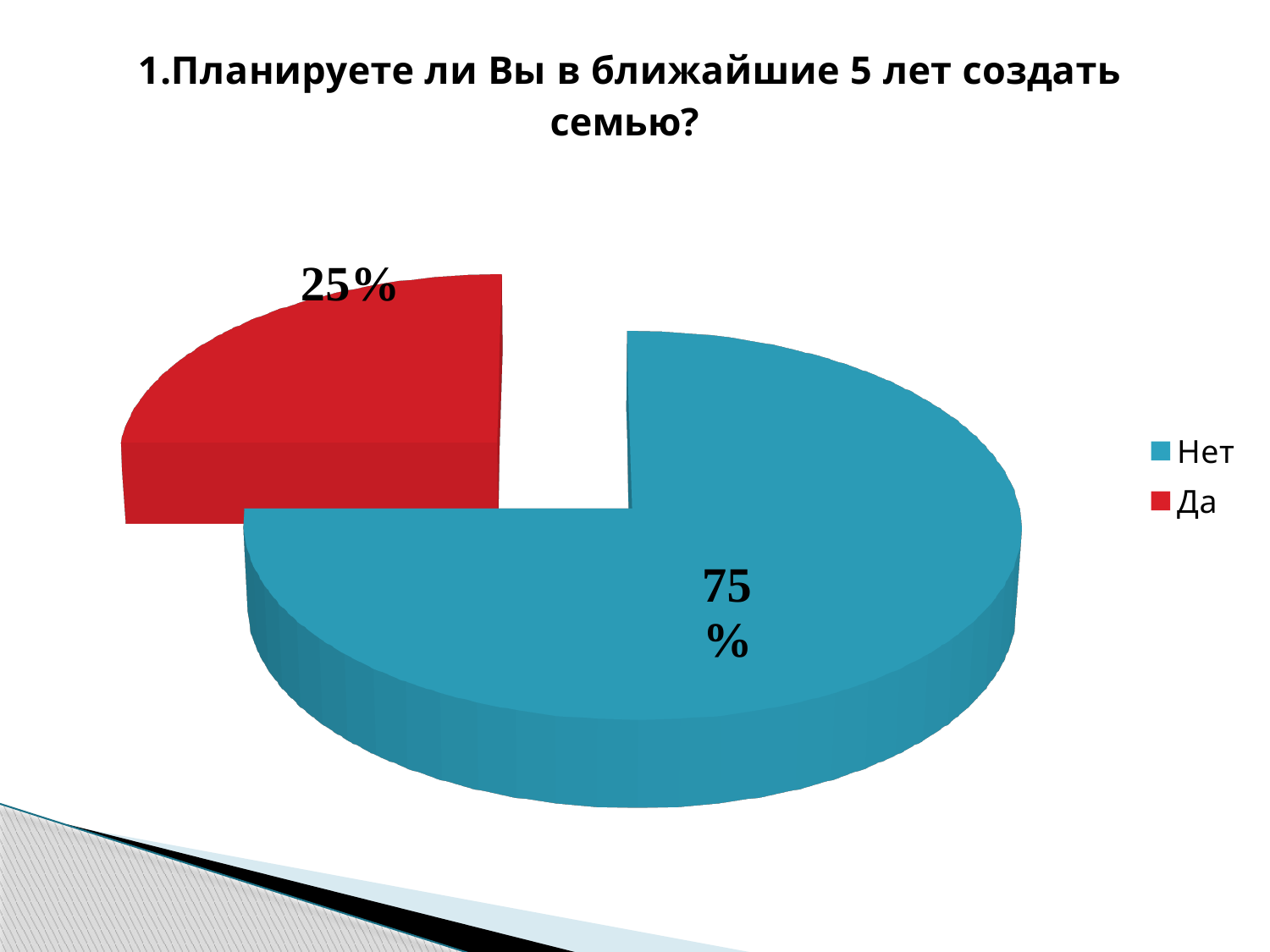
How many entries does the legend list? 2 What is the title of the chart? 1.Планируете ли Вы в ближайшие 5 лет создать семью? What is the difference in percentage points between the "Нет" and "Да" slices? 50 Which category has the smallest share of the pie? Да Which slice is larger, "Нет" or "Да"? Нет What percentage is shown for the "Да" slice? 25% What colour is the "Нет" slice? blue What kind of chart is shown on the slide? pie chart What share of the pie does the "Да" slice represent? 25% How many slices does the pie chart have? 2 What percentage is shown for the "Нет" slice? 75% Which category has the largest share of the pie? Нет